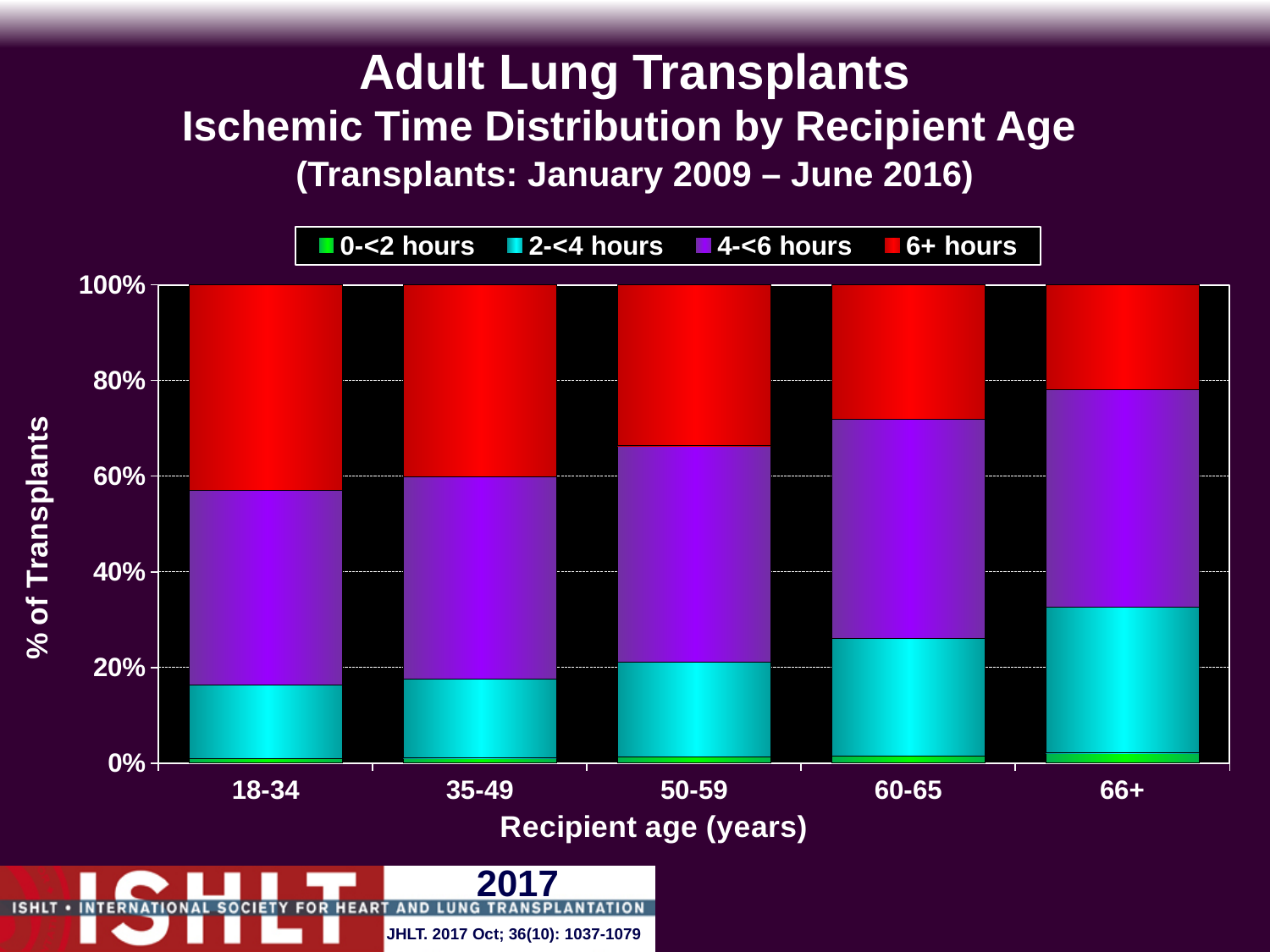
What kind of chart is shown on the slide? Stacked bar chart What is the total of each stacked bar? 100% How does the share of 6+ hours ischemic time change as recipient age increases from 18-34 to 66+? It falls Is the share of 2-<4 hours ischemic time for the 66+ group greater or less than 20%? greater Is the share of 6+ hours ischemic time larger for the 18-34 group or the 66+ group? 18-34 How many series does the legend list? 4 How many recipient age groups are shown on the x axis? 5 Is the share of 0-<2 hours ischemic time for the 50-59 group greater or less than 20%? less Which recipient age group has the smallest share of transplants with an ischemic time of 6+ hours? 66+ What is the label of the y axis? % of Transplants Which recipient age group has the largest share of transplants with an ischemic time of 2-<4 hours? 66+ Which colour represents the 4-<6 hours series in the legend? Purple